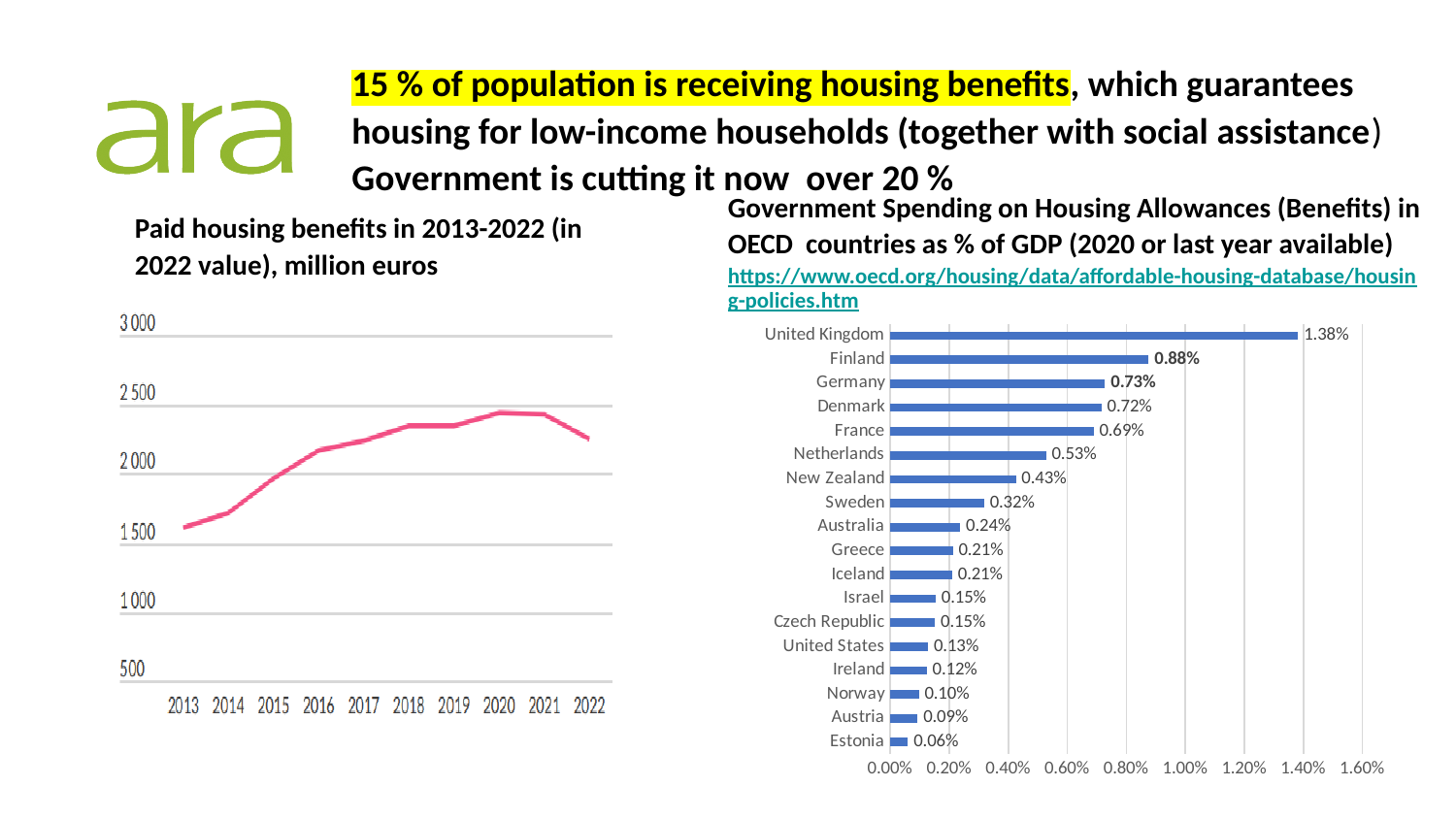
On the Paid housing benefits in 2013-2022 chart, is the value for 2020 greater or less than 2 000? greater On the Government Spending on Housing Allowances chart, which is larger, Sweden or New Zealand? New Zealand On the Government Spending on Housing Allowances chart, which country has the highest value? United Kingdom On the Government Spending on Housing Allowances chart, what is the difference between the United Kingdom and Finland? 0.50% On the Government Spending on Housing Allowances chart, what is the value for the Netherlands? 0.53% On the Government Spending on Housing Allowances chart, what is the value for Finland? 0.88% On the Government Spending on Housing Allowances chart, which country has the lowest value? Estonia On the Paid housing benefits in 2013-2022 chart, is the value for 2013 greater or less than 2 000? less What kind of chart is the Paid housing benefits in 2013-2022 chart? Line chart On the Government Spending on Housing Allowances chart, how many countries are shown? 18 On the Paid housing benefits in 2013-2022 chart, how many years are shown on the x axis? 10 What kind of chart is the Government Spending on Housing Allowances chart? Bar chart